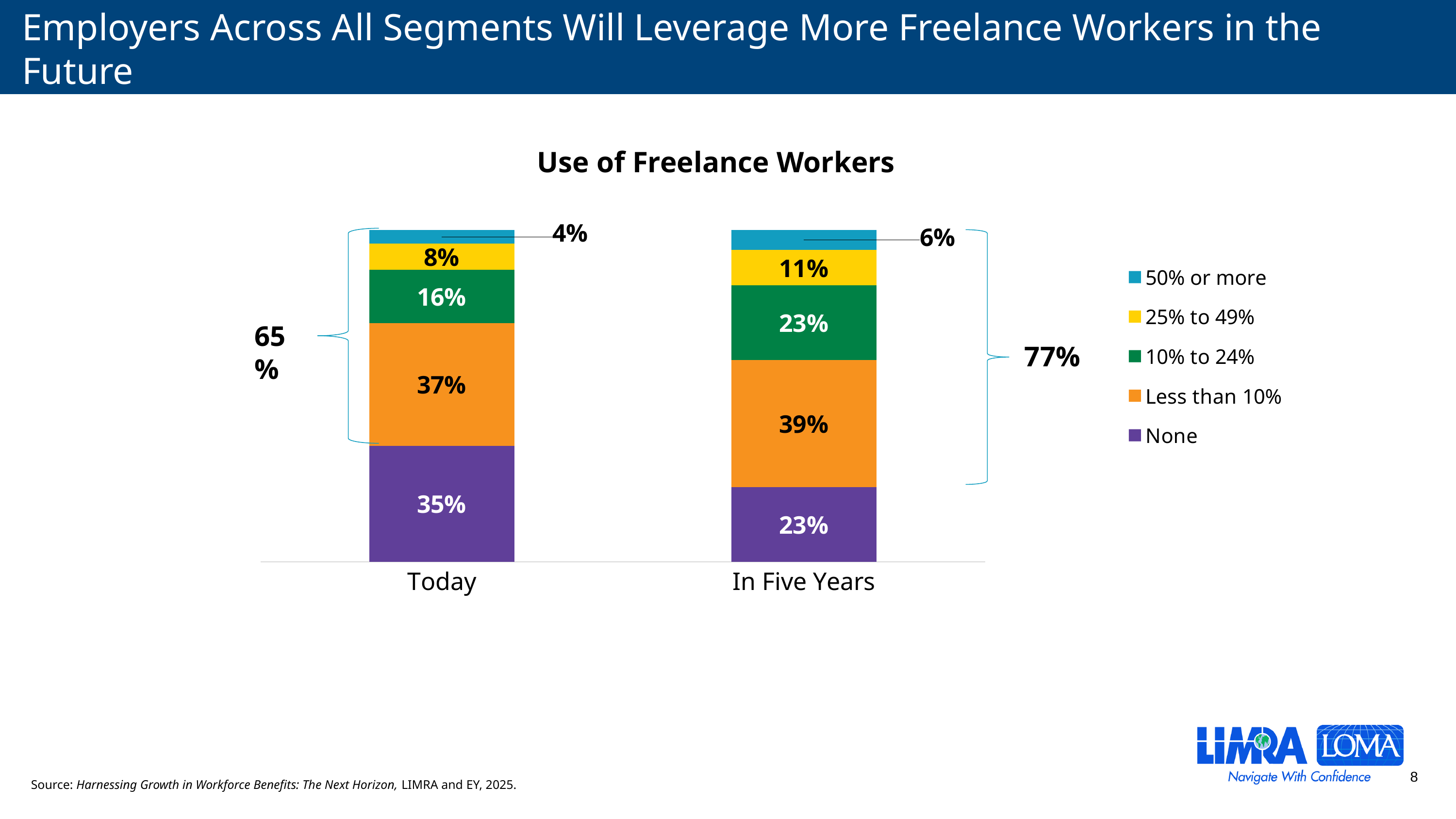
How many series does the legend list? 5 What is the title of the chart? Use of Freelance Workers What is the value for "None" in the Today bar? 35% What is the difference between the "10% to 24%" values for In Five Years and Today? 7% How many categories are shown on the x axis? 2 Which is larger: the "None" value for Today or for In Five Years? Today Which segment is the smallest in the Today bar? 50% or more What is the value for "50% or more" in the Today bar? 4% What is the value for "25% to 49%" in the In Five Years bar? 11% What is the value for "Less than 10%" in the In Five Years bar? 39% Which segment is the largest in the In Five Years bar? Less than 10% What kind of chart is shown? Stacked bar chart